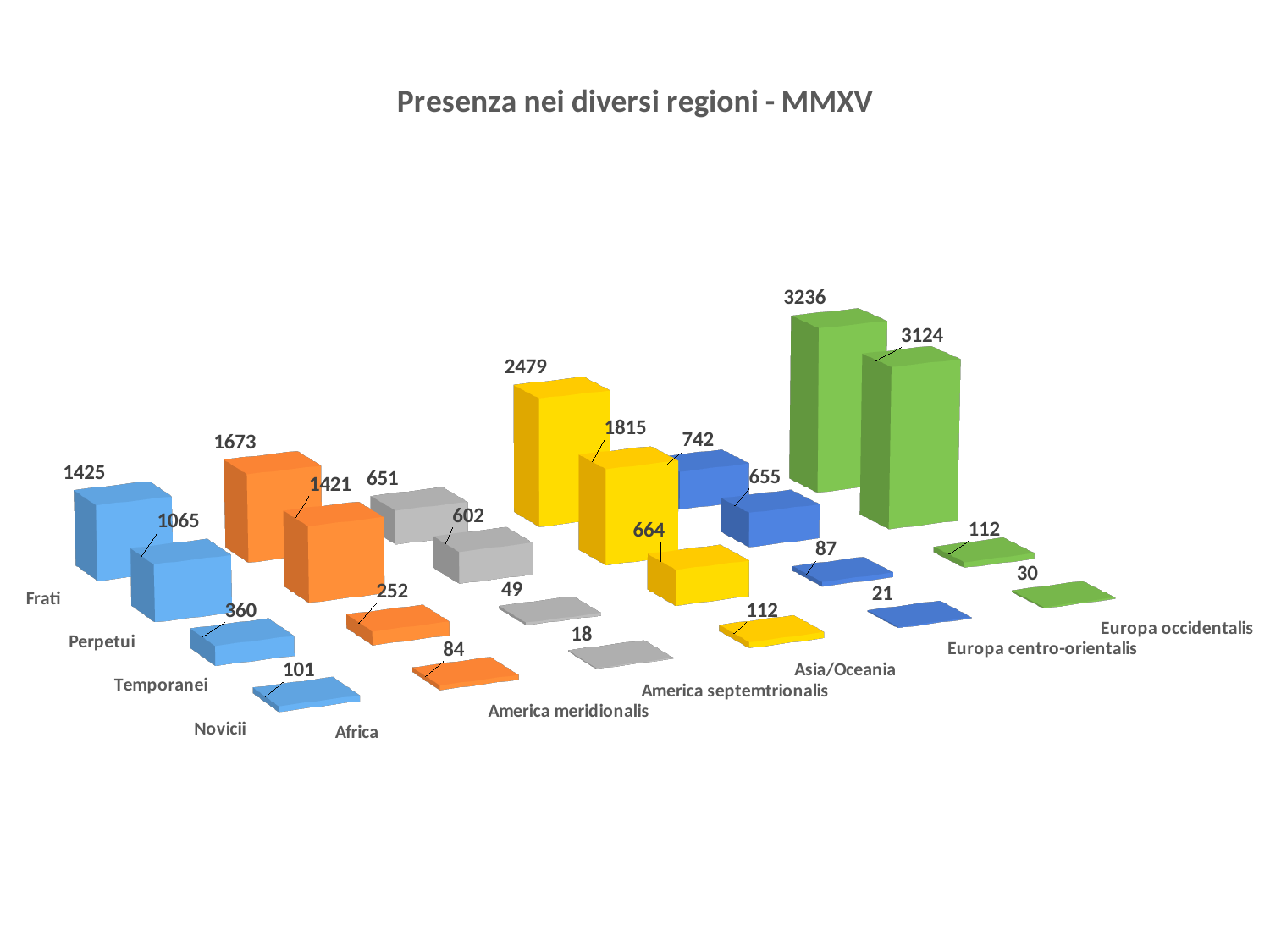
What is the difference between the Frati and Perpetui values for Europa occidentalis? 112 How many regions are shown on the chart? 6 What is the difference between the Temporanei values for Asia/Oceania and Europa centro-orientalis? 577 What is the Perpetui value for Asia/Oceania? 1815 What is the title of the chart? Presenza nei diversi regioni - MMXV Which is larger, the Frati value for Africa or the Frati value for America meridionalis? America meridionalis What type of chart is shown on the slide? bar chart Which region has the highest Frati value? Europa occidentalis What is the Frati value for Europa occidentalis? 3236 What is the Novicii value for America septemtrionalis? 18 What is the Temporanei value for Africa? 360 Which region has the lowest Novicii value? America septemtrionalis